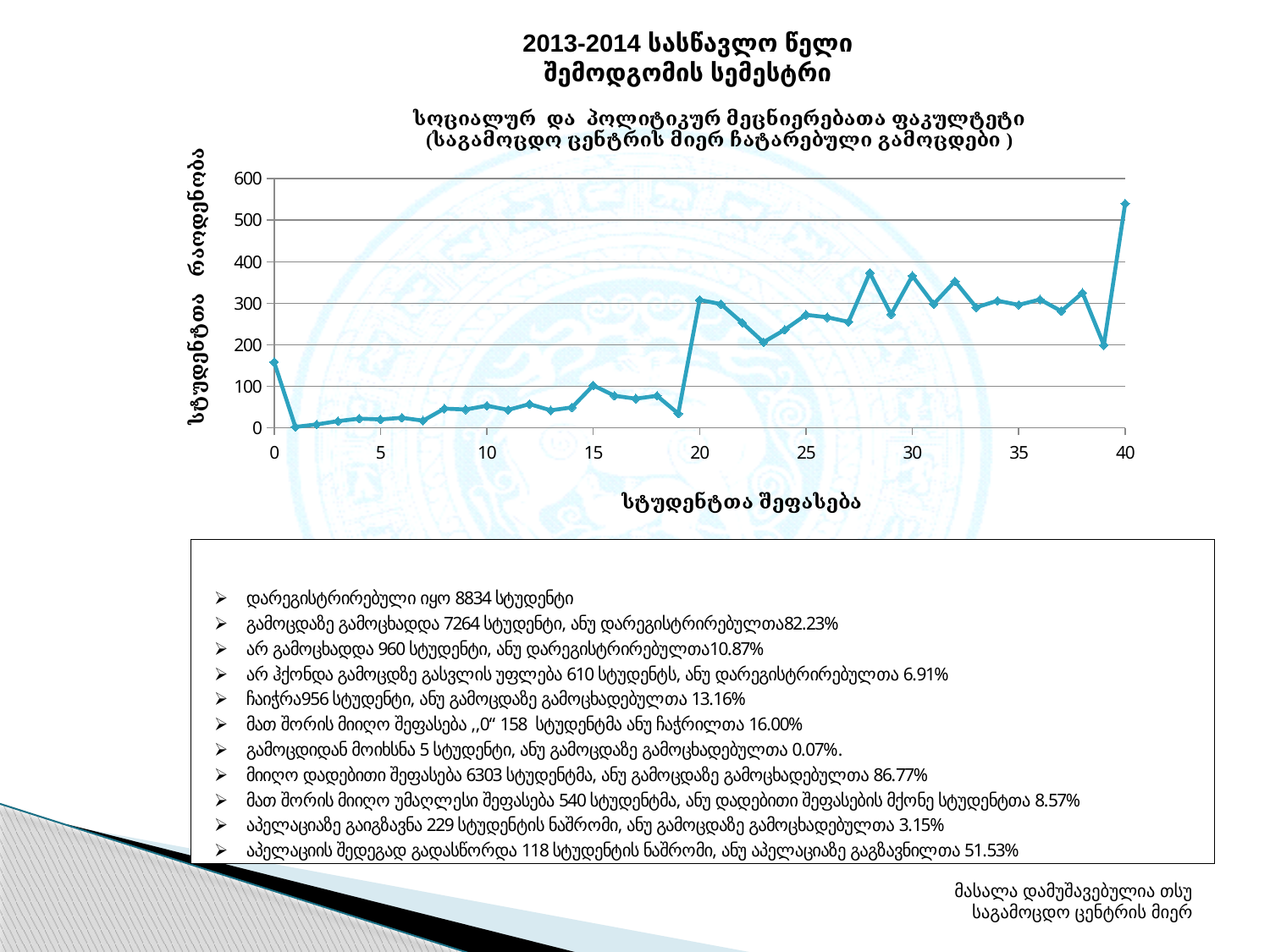
Does the line rise or fall between x = 19 and x = 20? rise Is the value at x = 10 greater or less than 100? less What is the title of the y axis of the chart? სტუდენტთა რაოდენობა Which is larger, the value at x = 20 or the value at x = 19? x = 20 Is the value at x = 40 greater or less than 500? greater Which is larger, the value at x = 10 or the value at x = 30? x = 30 What kind of chart is shown on the slide? line chart What is the title of the x axis of the chart? სტუდენტთა შეფასება At which x-axis value does the line reach its highest point? 40 Is the value at x = 23 greater or less than 300? less